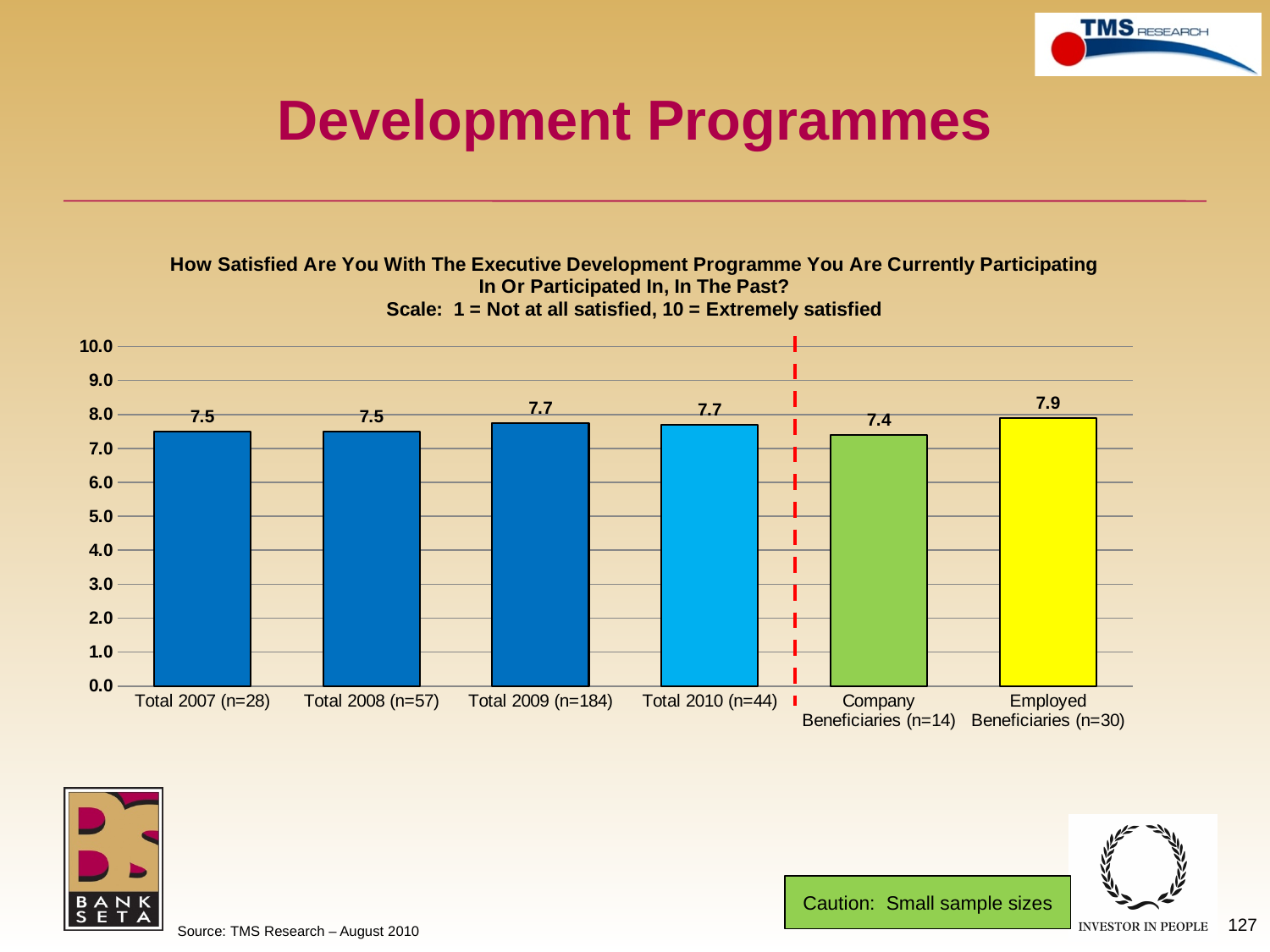
What is the value for Employed Beneficiaries (n=30)? 7.9 Which category has the lowest value? Company Beneficiaries (n=14) Which is larger, the value for Total 2010 (n=44) or the value for Total 2008 (n=57)? Total 2010 (n=44) What kind of chart is shown on the slide? bar chart How many categories are shown on the chart? 6 What is the maximum value shown on the vertical axis? 10.0 Is the value for Total 2010 (n=44) greater or less than 8.0? less What is the value for Total 2007 (n=28)? 7.5 What is the difference between the values for Employed Beneficiaries (n=30) and Company Beneficiaries (n=14)? 0.5 Which category has the highest value? Employed Beneficiaries (n=30) What is the value for Company Beneficiaries (n=14)? 7.4 What is the value for Total 2009 (n=184)? 7.7